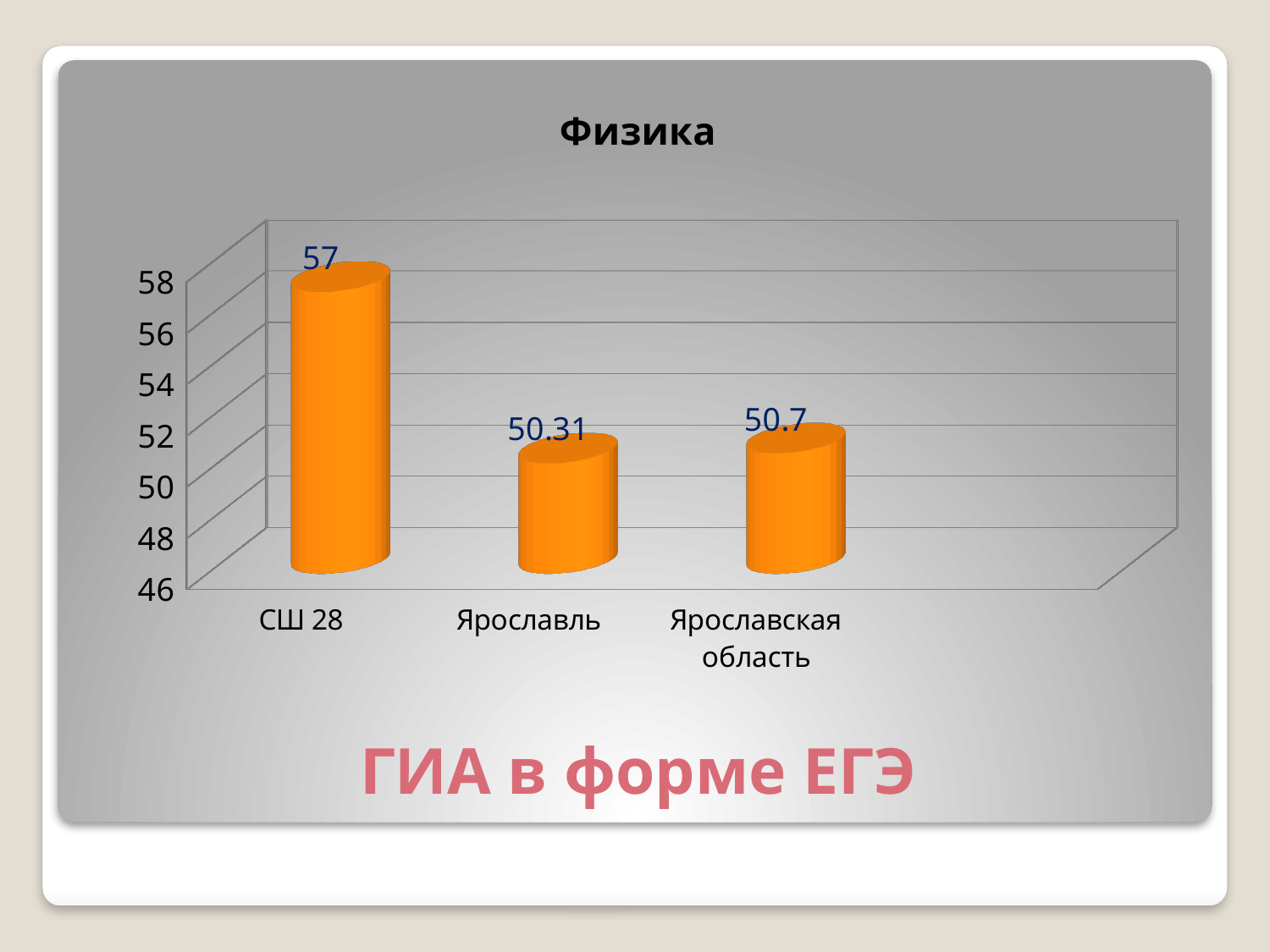
Which category has the lowest value? Ярославль Which category has the highest value? СШ 28 Is the value for СШ 28 greater or less than 54? greater What kind of chart is shown on the slide? bar chart What is the value for СШ 28? 57 How many categories are shown on the chart? 3 Which is larger, the value for СШ 28 or the value for Ярославская область? СШ 28 What is the difference between the values for Ярославская область and Ярославль? 0.39 What is the title of the chart? Физика What is the value for Ярославль? 50.31 What is the difference between the values for СШ 28 and Ярославль? 6.69 What is the value for Ярославская область? 50.7